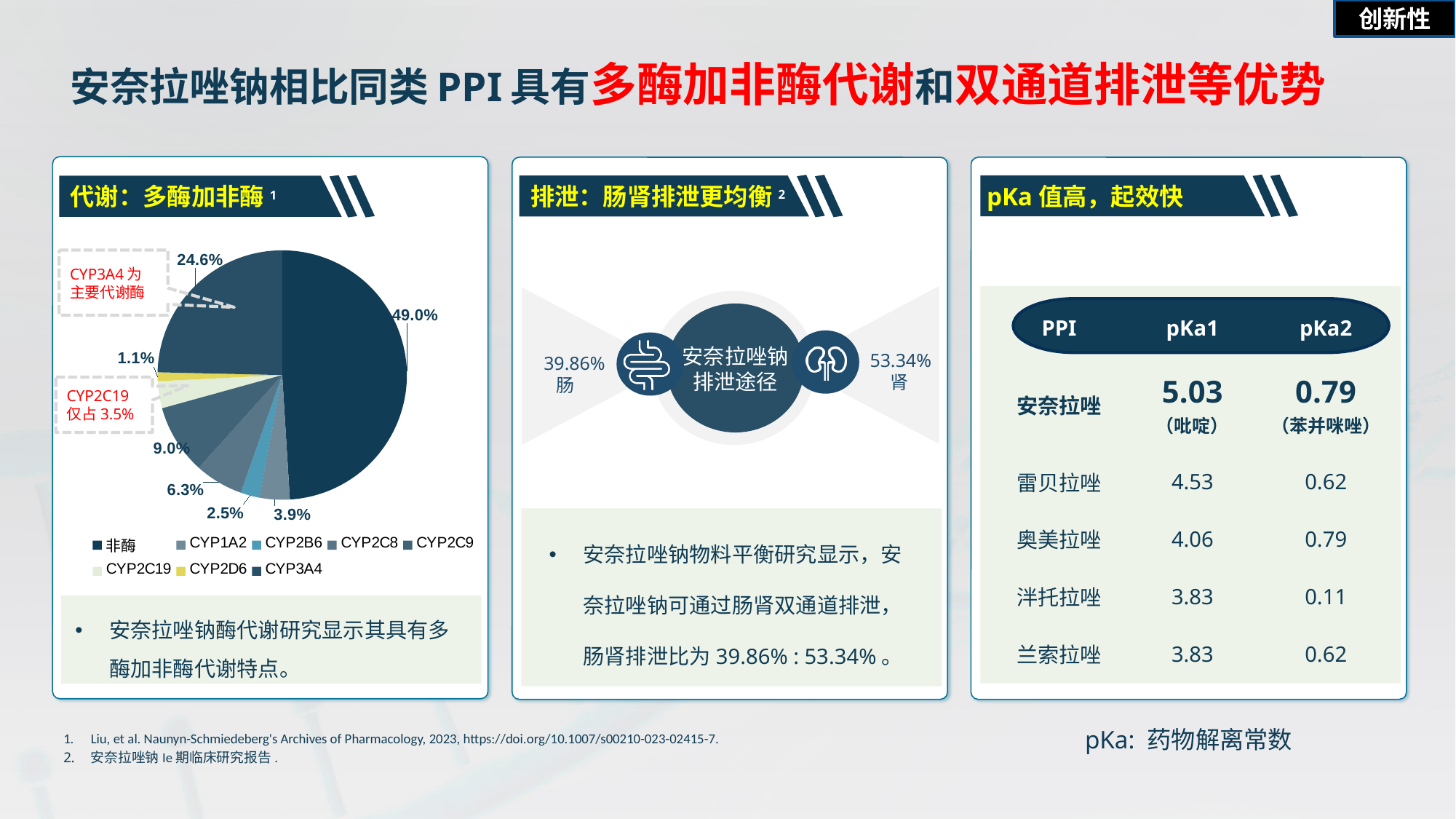
In the pie chart, which has the larger share, CYP2C8 or CYP1A2? CYP2C8 What is the difference between the shares of 非酶 and CYP3A4 in the pie chart? 24.4% What is the share of CYP2C8 in the pie chart? 6.3% What colour is the CYP2D6 slice in the pie chart? yellow How many categories does the legend of the pie chart list? 8 What is the share of CYP2B6 in the pie chart? 2.5% What is the share of CYP3A4 in the pie chart? 24.6% Which category has the smallest share in the pie chart? CYP2D6 What is the share of 非酶 in the pie chart? 49.0% What is the share of CYP2C9 in the pie chart? 9.0% What kind of chart is shown in the left panel (代谢：多酶加非酶)? pie chart Which category has the largest share in the pie chart? 非酶